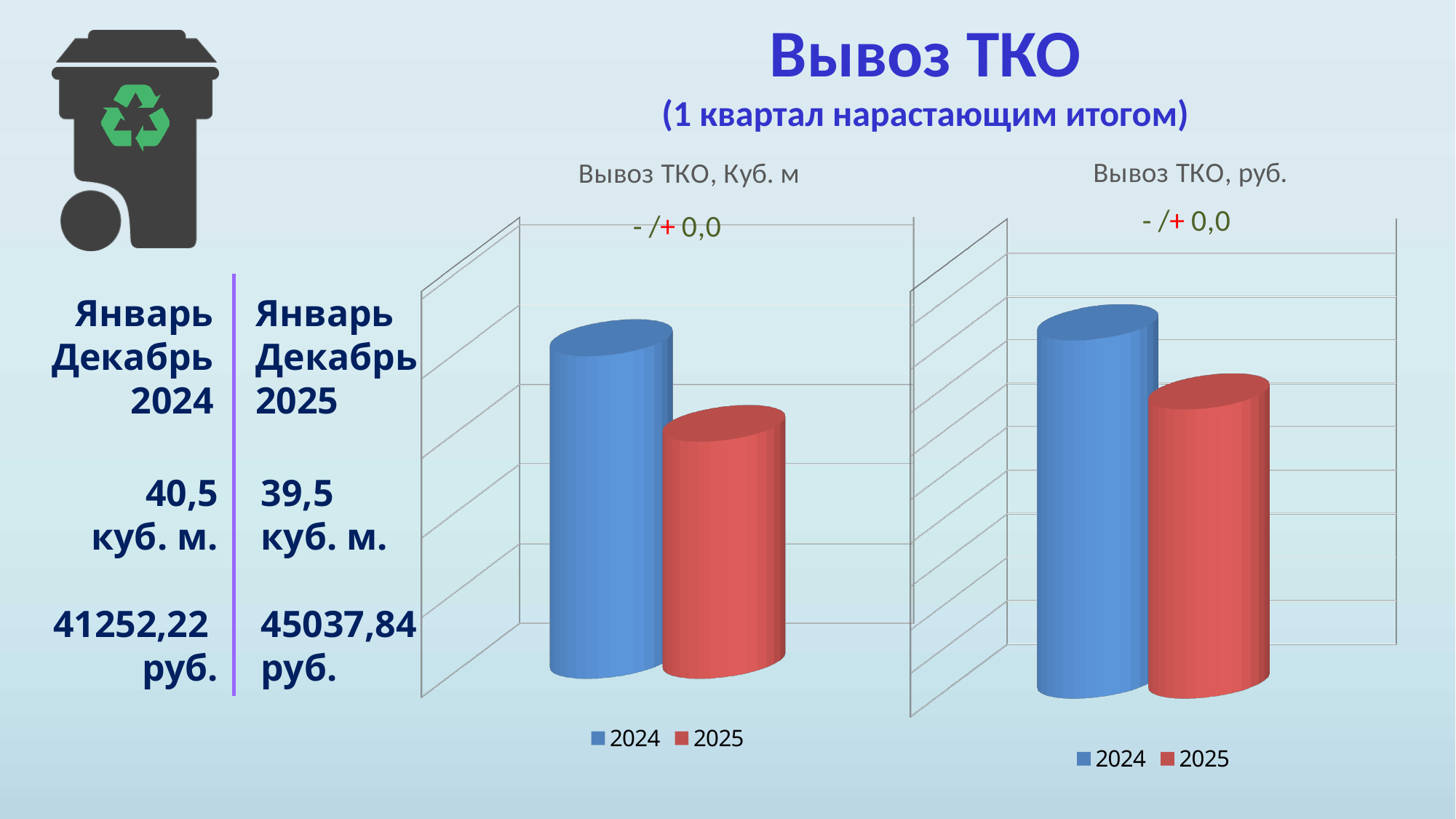
In the "Вывоз ТКО, руб." chart, what colour is the bar for the 2025 series? red What kind of chart is the "Вывоз ТКО, руб." chart on the right? bar chart In the "Вывоз ТКО, Куб. м" chart, how many series does the legend list? 2 In the "Вывоз ТКО, руб." chart, which series has the highest bar? 2024 What kind of chart is the "Вывоз ТКО, Куб. м" chart on the left? bar chart In the "Вывоз ТКО, Куб. м" chart, which series has the taller bar, 2024 or 2025? 2024 In the "Вывоз ТКО, руб." chart, how many bars are plotted? 2 In the "Вывоз ТКО, руб." chart, how many series does the legend list? 2 In the "Вывоз ТКО, Куб. м" chart, which series has the lowest bar? 2025 In the "Вывоз ТКО, Куб. м" chart, how many bars are plotted? 2 What are the two series names listed in the legend of the "Вывоз ТКО, Куб. м" chart? 2024 and 2025 In the "Вывоз ТКО, руб." chart, which series has the taller bar, 2024 or 2025? 2024